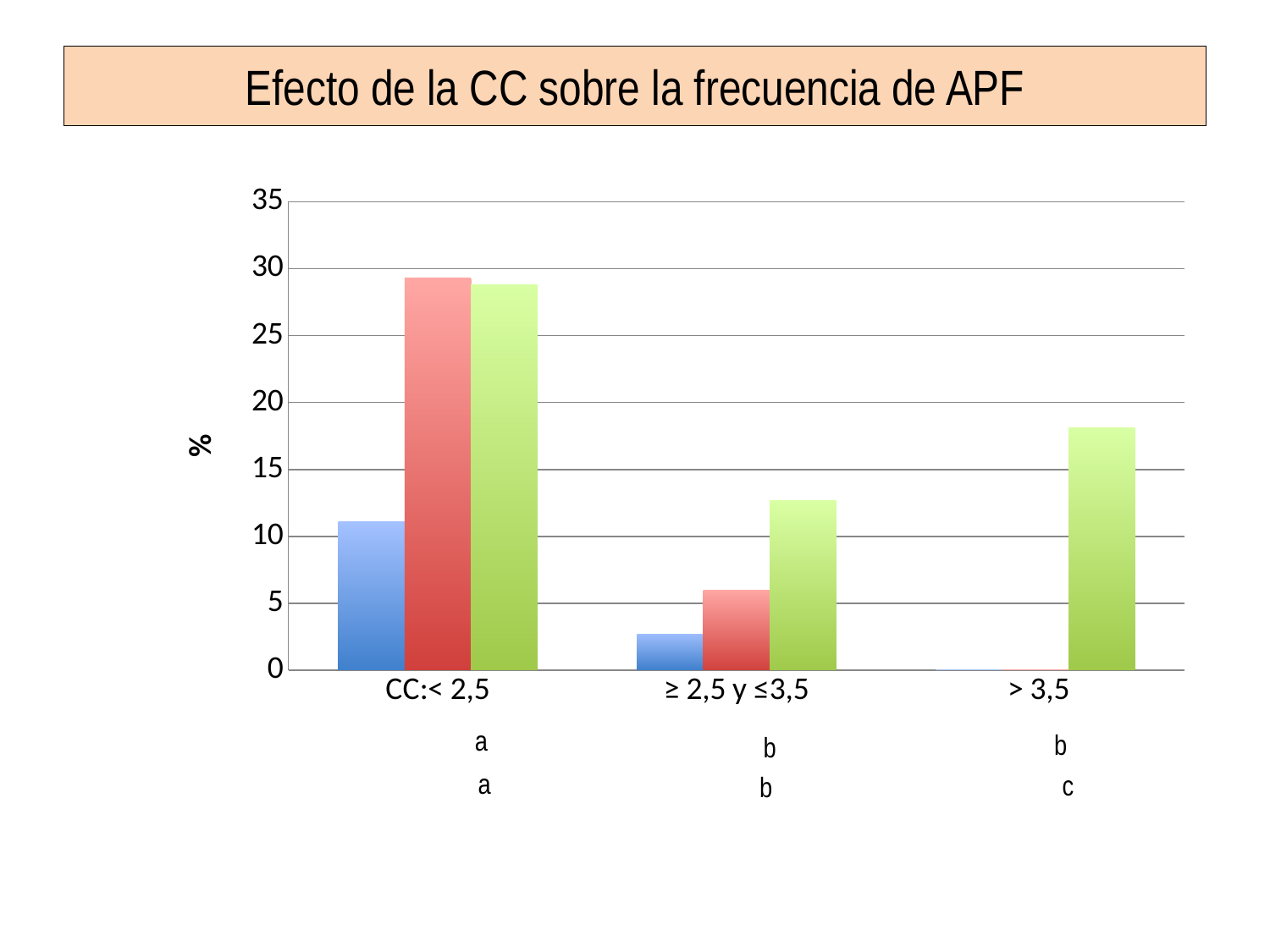
Is the value of the red bar for "CC:< 2,5" greater or less than 25? greater Which is larger: the green bar for "> 3,5" or the green bar for "≥ 2,5 y ≤3,5"? > 3,5 Is the value of the green bar for "> 3,5" greater or less than 15? greater What kind of chart is shown on the slide? bar chart Is the value of the blue bar for "CC:< 2,5" greater or less than 10? greater What is the title of the chart on the slide? Efecto de la CC sobre la frecuencia de APF How many categories are shown on the x axis of the chart? 3 Within the category "≥ 2,5 y ≤3,5", which coloured bar is the lowest? blue What is the label on the vertical axis of the chart? % Among the green bars, which category has the highest value? CC:< 2,5